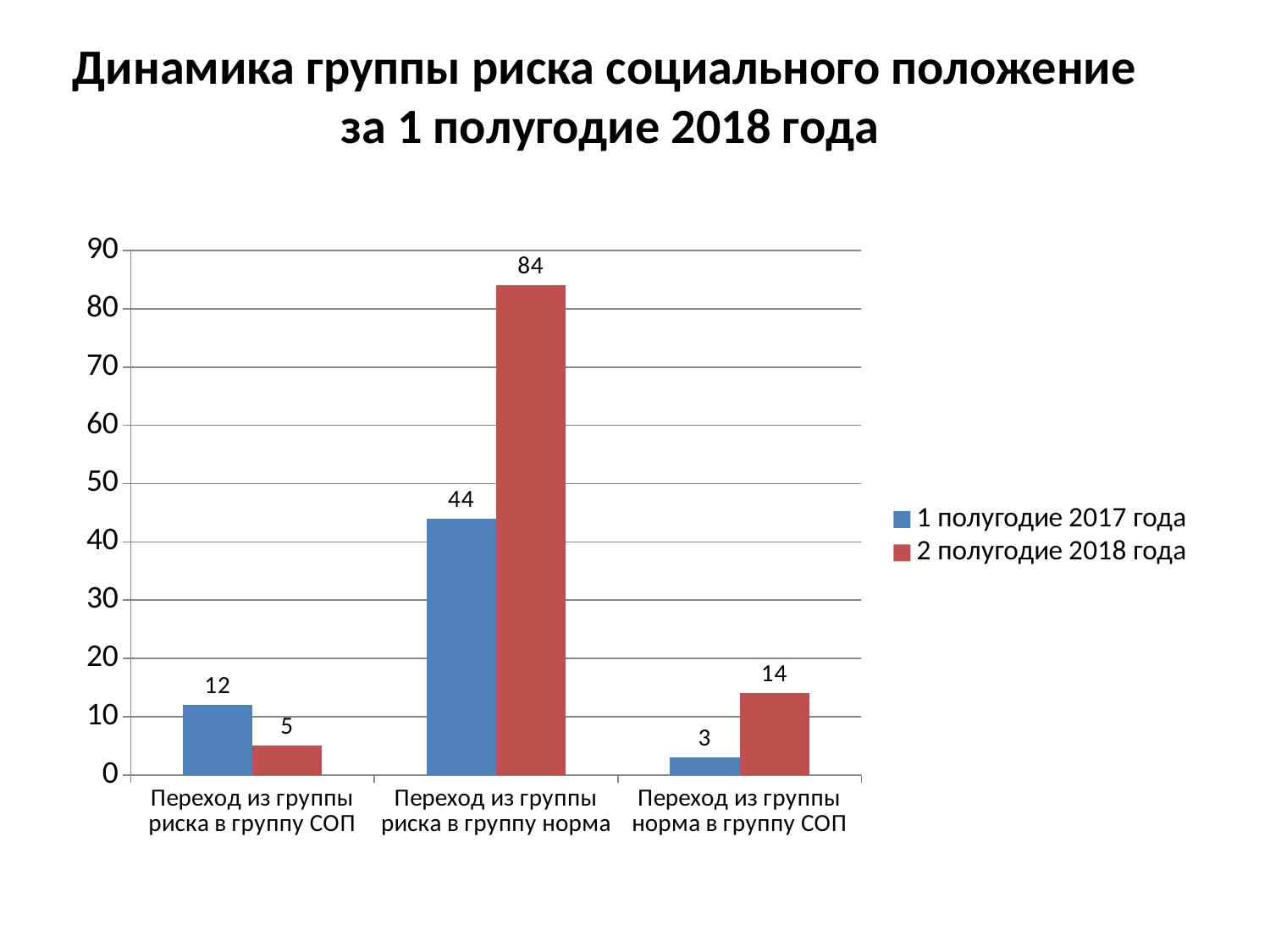
What kind of chart is shown on the slide? bar chart What is the difference between the "2 полугодие 2018 года" and "1 полугодие 2017 года" values for "Переход из группы риска в группу норма"? 40 Which category has the highest value in the "1 полугодие 2017 года" series? Переход из группы риска в группу норма What is the value for "Переход из группы риска в группу норма" in the "2 полугодие 2018 года" series? 84 How many categories are shown on the x axis? 3 How many series does the legend list? 2 What is the value for "Переход из группы риска в группу СОП" in the "1 полугодие 2017 года" series? 12 Which category has the lowest value in the "2 полугодие 2018 года" series? Переход из группы риска в группу СОП What colour are the bars for the "2 полугодие 2018 года" series? red What is the value for "Переход из группы норма в группу СОП" in the "2 полугодие 2018 года" series? 14 Is the value for "Переход из группы риска в группу норма" in the "1 полугодие 2017 года" series greater or less than 50? less For "Переход из группы риска в группу СОП", which series has the larger value: "1 полугодие 2017 года" or "2 полугодие 2018 года"? 1 полугодие 2017 года